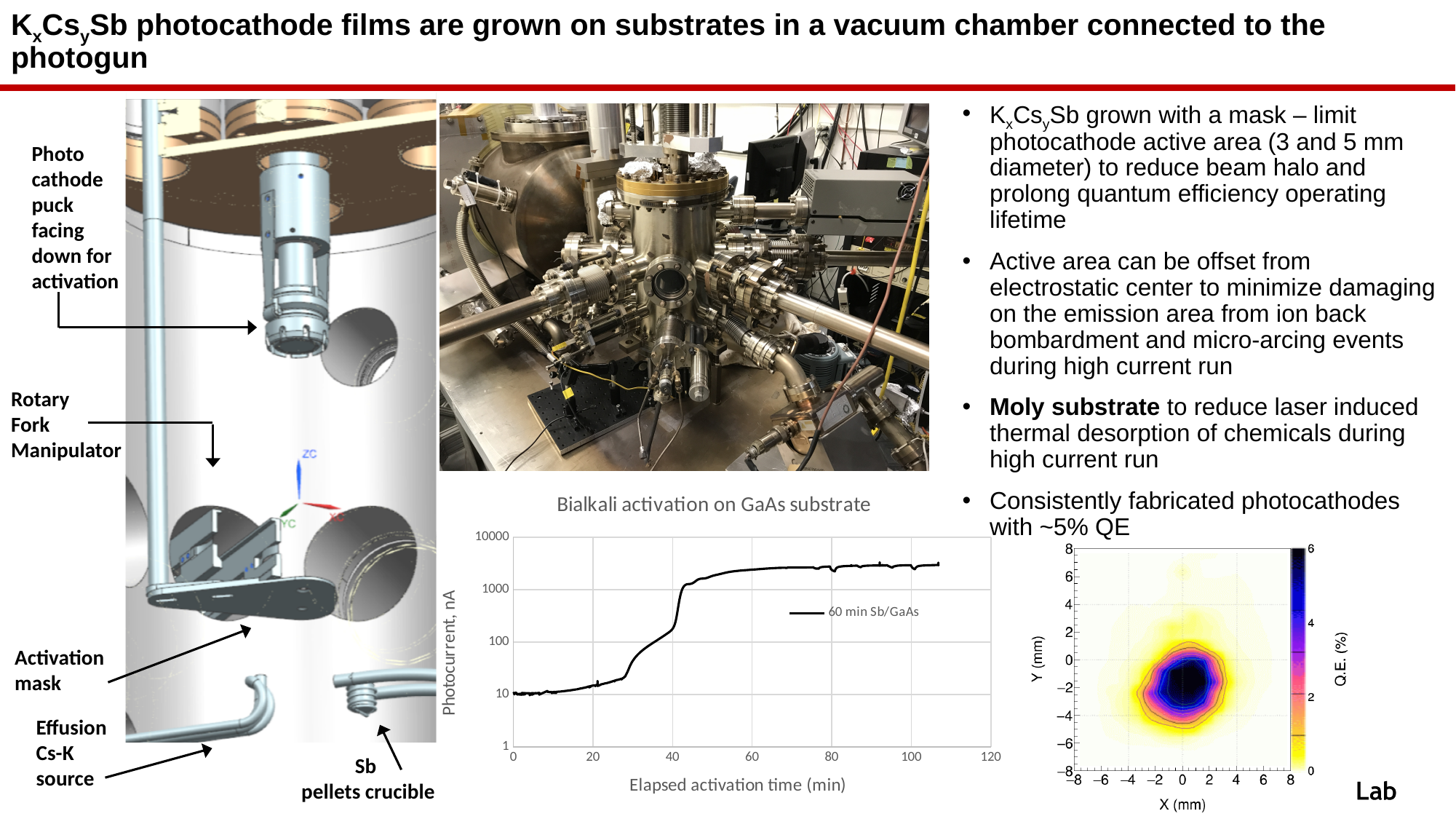
In the 'Bialkali activation on GaAs substrate' chart, which is larger: the photocurrent at 20 min or at 80 min? 80 min In the 'Bialkali activation on GaAs substrate' chart, is the photocurrent at 60 min greater or less than 1000 nA? greater In the 'Bialkali activation on GaAs substrate' chart, is the photocurrent at 10 min greater or less than 100 nA? less What is the x-axis label of the 'Bialkali activation on GaAs substrate' chart? Elapsed activation time (min) In the 'Bialkali activation on GaAs substrate' chart, is the photocurrent at 30 min greater or less than 10 nA? greater What is the highest tick value on the y-axis of the 'Bialkali activation on GaAs substrate' chart? 10000 In the 'Bialkali activation on GaAs substrate' chart, does the photocurrent rise or fall as elapsed activation time increases? rise What is the legend entry of the series in the 'Bialkali activation on GaAs substrate' chart? 60 min Sb/GaAs How many series does the legend of the 'Bialkali activation on GaAs substrate' chart list? 1 What kind of chart is the 'Bialkali activation on GaAs substrate' chart? line chart What is the maximum value shown on the Q.E. (%) colour scale of the heat map at the bottom right of the slide? 6